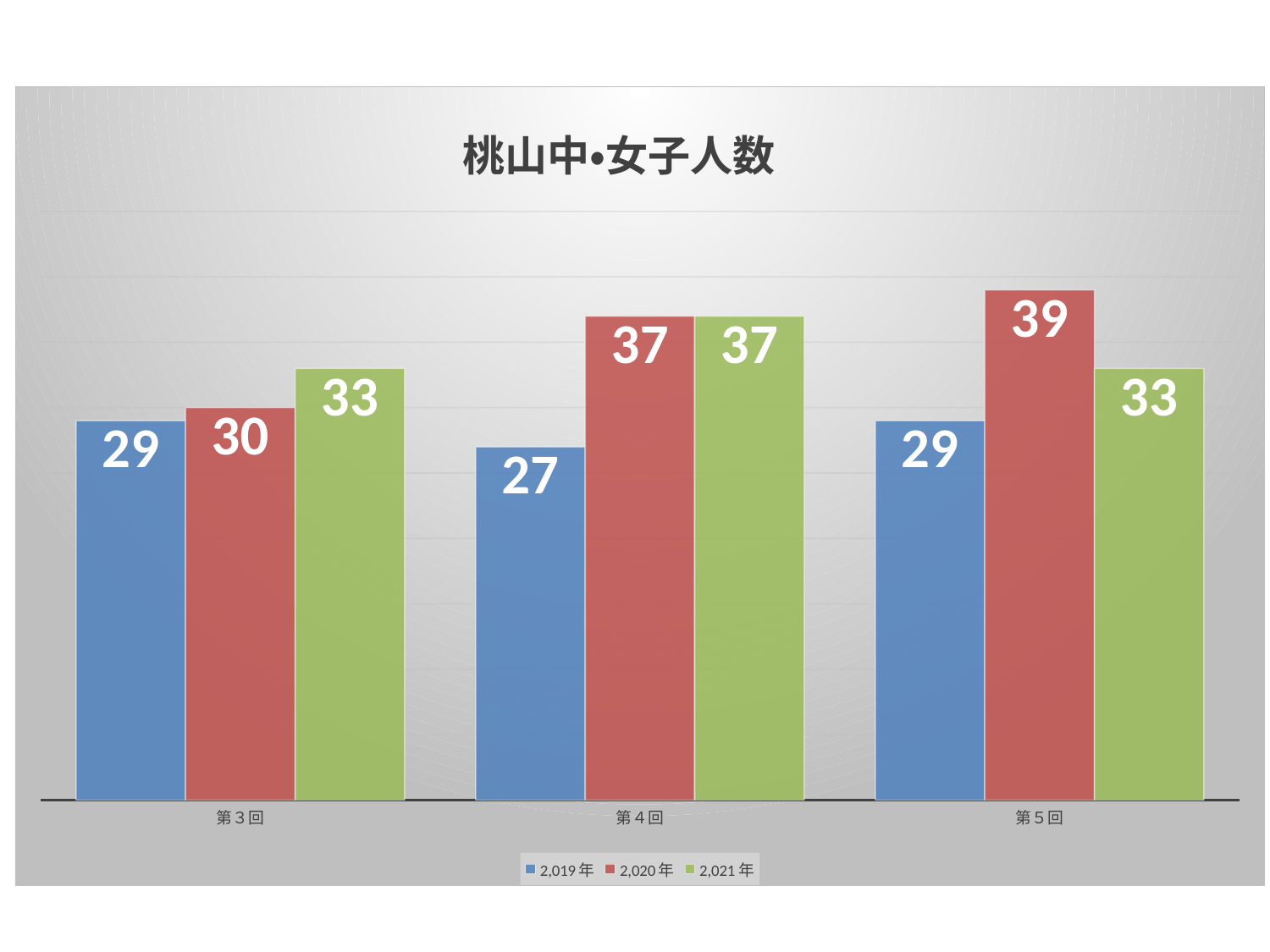
Which category has the lowest value for the 2,019年 series? 第4回 What kind of chart is this? bar chart How many categories are shown on the x axis? 3 What is the value for 2,019年 at 第3回? 29 What colour are the bars for the 2,021年 series? green How many series does the legend list? 3 What is the value for 2,021年 at 第5回? 33 What is the title of the chart? 桃山中•女子人数 Which is larger at 第3回: the 2,020年 value or the 2,021年 value? 2,021年 Which category has the highest value for the 2,020年 series? 第5回 What is the value for 2,020年 at 第4回? 37 What is the difference between the 2,020年 and 2,019年 values at 第5回? 10